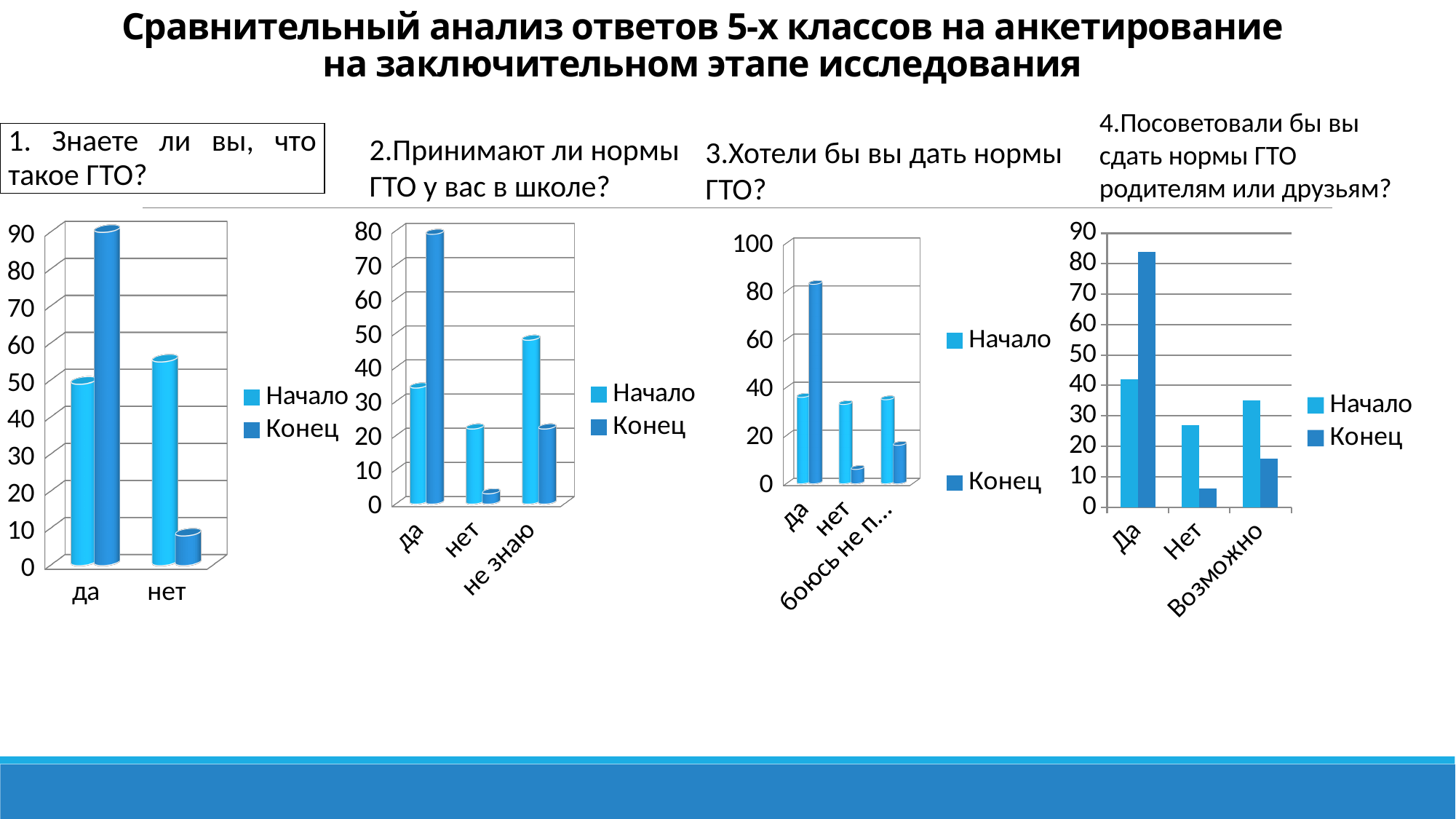
In the chart for question 3 ("Хотели бы вы дать нормы ГТО?"), is the value for "Да" in the "Конец" series greater or less than 60? greater In the chart for question 3 ("Хотели бы вы дать нормы ГТО?"), which series has the larger value for "нет": "Начало" or "Конец"? Начало How many series does the legend list in the chart for question 4 ("Посоветовали бы вы сдать нормы ГТО родителям или друзьям?")? 2 In the chart for question 4 ("Посоветовали бы вы сдать нормы ГТО родителям или друзьям?"), which category has the highest "Конец" value? Да In the chart for question 2 ("Принимают ли нормы ГТО у вас в школе?"), which category has the lowest "Конец" value? нет How many categories are shown on the x axis of the chart for question 2 ("Принимают ли нормы ГТО у вас в школе?")? 3 In the chart for question 2 ("Принимают ли нормы ГТО у вас в школе?"), which category has the highest "Конец" value? да In the chart for question 4 ("Посоветовали бы вы сдать нормы ГТО родителям или друзьям?"), is the value for "Нет" in the "Конец" series greater or less than 10? less In the chart for question 1 ("Знаете ли вы, что такое ГТО?"), which series has the larger value for "да": "Начало" or "Конец"? Конец In the chart for question 1 ("Знаете ли вы, что такое ГТО?"), is the value for "да" in the "Конец" series greater or less than 80? greater